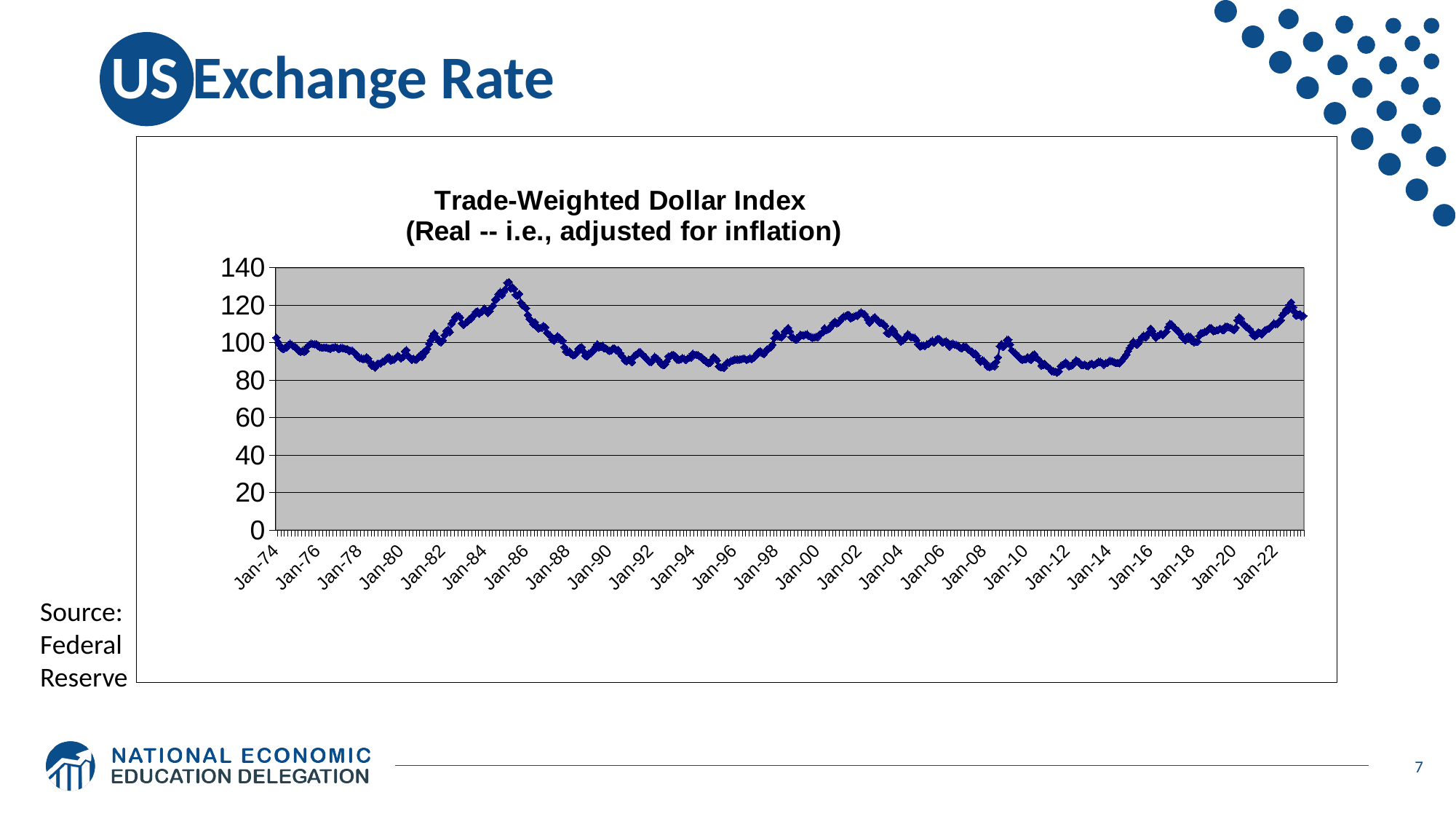
Is the peak value of the index around Jan-86 greater or less than 120? greater Is the value of the index around Jan-22 greater or less than 100? greater Around which year does the Trade-Weighted Dollar Index reach its highest value? 1985 Does the index rise or fall between Jan-80 and Jan-85? rise What is the highest value shown on the vertical axis? 140 What is the title of the chart? Trade-Weighted Dollar Index (Real -- i.e., adjusted for inflation) Which is larger, the index value around Jan-86 or around Jan-02? Jan-86 What kind of chart is shown on the slide? line chart Is the value of the index around Jan-12 greater or less than 100? less Does the index rise or fall between Jan-86 and Jan-88? fall